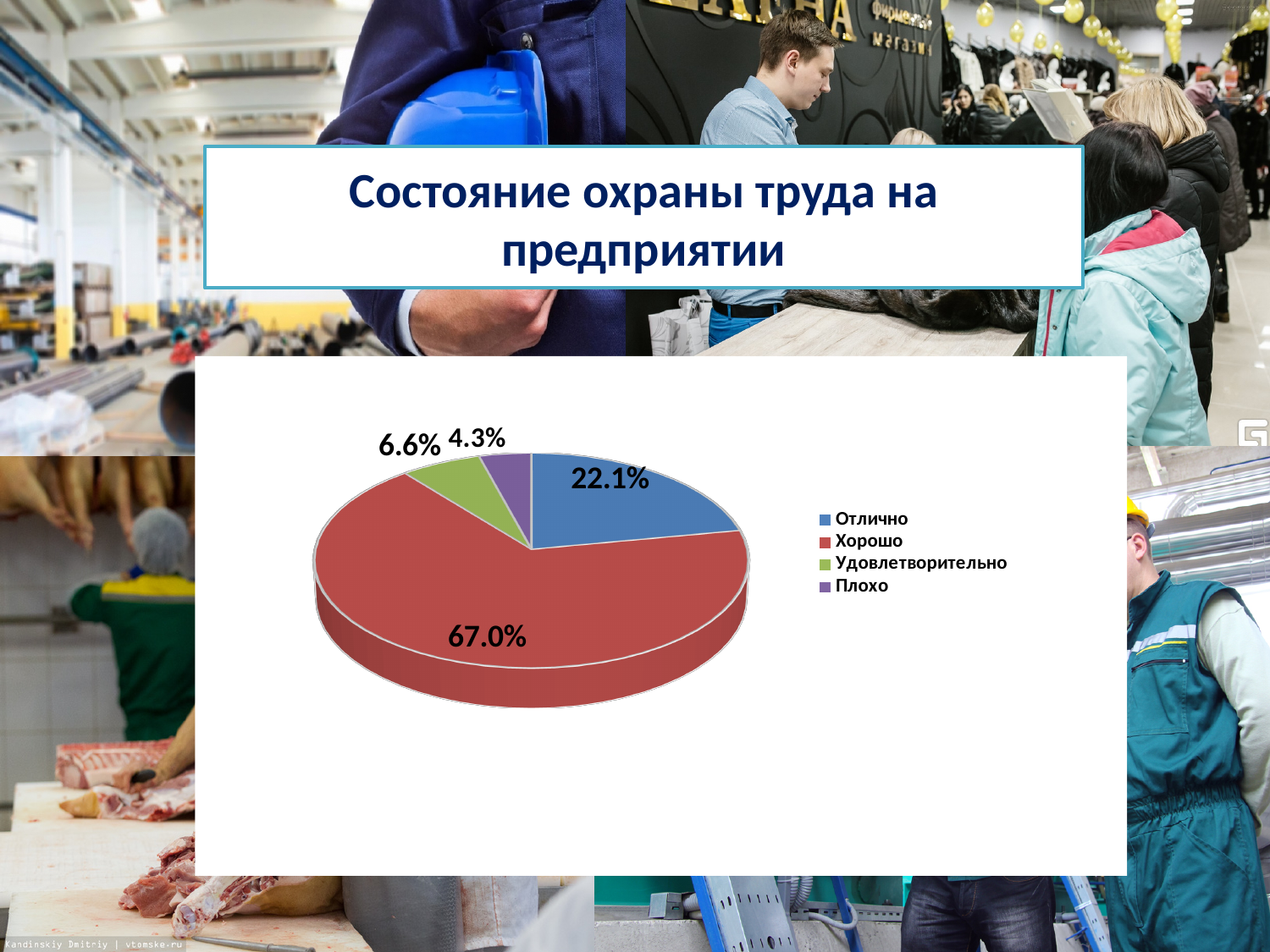
What kind of chart is shown on the slide? pie chart What percentage of the pie is labelled "Плохо"? 4.3% What percentage of the pie is labelled "Хорошо"? 67.0% Which category has the smallest share of the pie? Плохо What is the title shown above the chart? Состояние охраны труда на предприятии How many slices does the pie chart have? 4 What is the difference in percentage points between "Хорошо" and "Отлично"? 44.9 What percentage of the pie is labelled "Удовлетворительно"? 6.6% Which category has the largest share of the pie? Хорошо Which is larger, the share for "Удовлетворительно" or the share for "Плохо"? Удовлетворительно What percentage of the pie is labelled "Отлично"? 22.1% How many entries does the legend list? 4